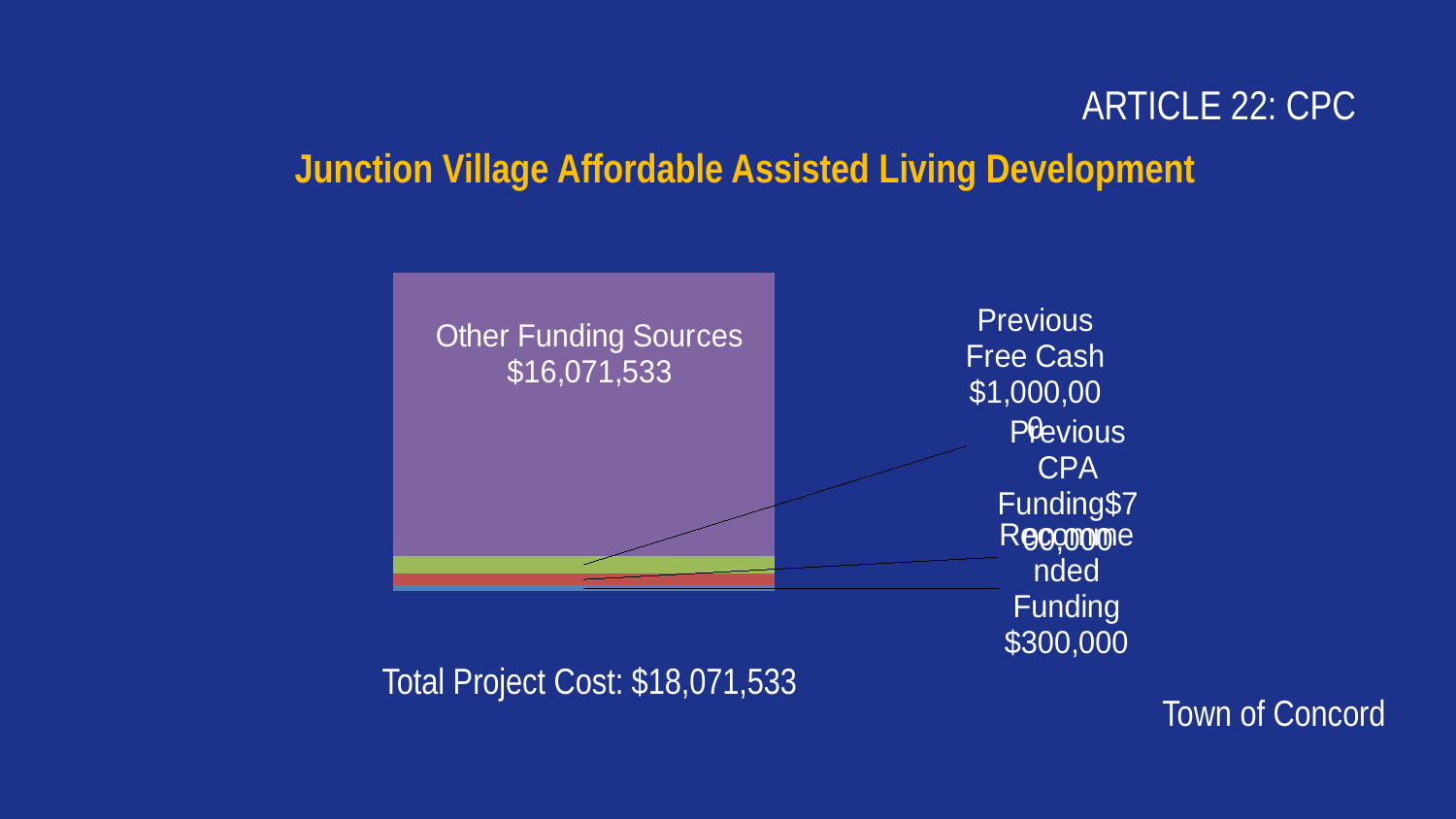
Which funding segment is the largest in the bar? Other Funding Sources Which funding segment is the smallest in the bar? Recommended Funding What is the total of all segments in the stacked bar (the Total Project Cost)? $18,071,533 How many funding segments make up the stacked bar? 4 What is the difference between Other Funding Sources and Recommended Funding? $15,771,533 What kind of chart is shown on the slide? Stacked bar chart What colour is the Other Funding Sources segment of the bar? Purple What is the value of the Previous Free Cash segment? $1,000,000 Which is larger, Previous Free Cash or Previous CPA Funding? Previous Free Cash What is the value of the Previous CPA Funding segment? $700,000 What is the value of the Other Funding Sources segment in the stacked bar? $16,071,533 What is the value of the Recommended Funding segment? $300,000